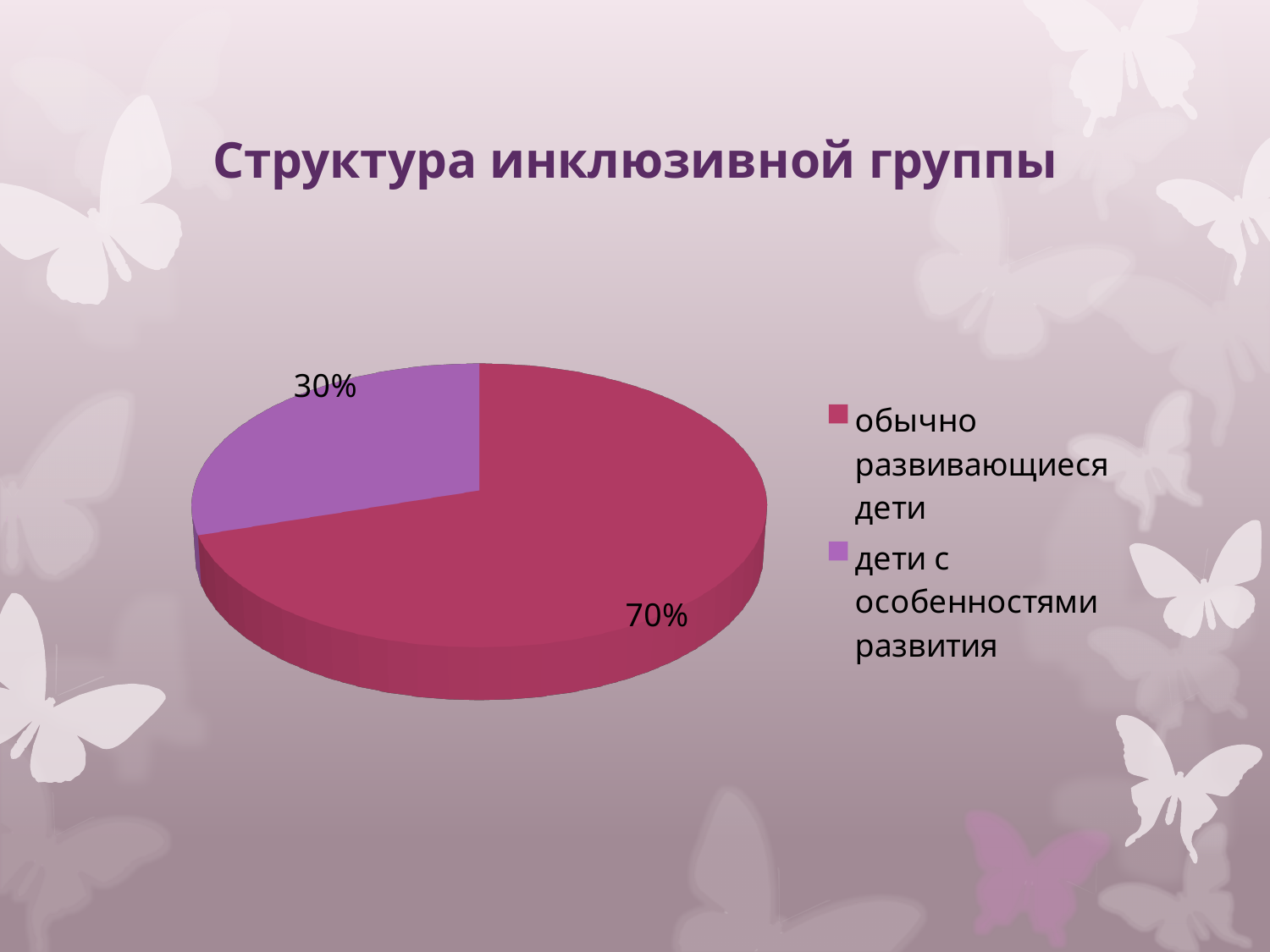
How many slices does the pie chart have? 2 Which category has the smallest slice of the pie? дети с особенностями развития Which slice is larger: 'обычно развивающиеся дети' or 'дети с особенностями развития'? обычно развивающиеся дети What colour is the slice for 'дети с особенностями развития'? purple Which category has the largest slice of the pie? обычно развивающиеся дети What share of the pie is labelled for 'дети с особенностями развития'? 30% What is the title of the slide? Структура инклюзивной группы What is the difference in percentage points between the two slices? 40 What is the total of the two slice percentages shown? 100% What kind of chart is shown on the slide? pie chart What share of the pie is labelled for 'обычно развивающиеся дети'? 70% How many entries does the legend list? 2